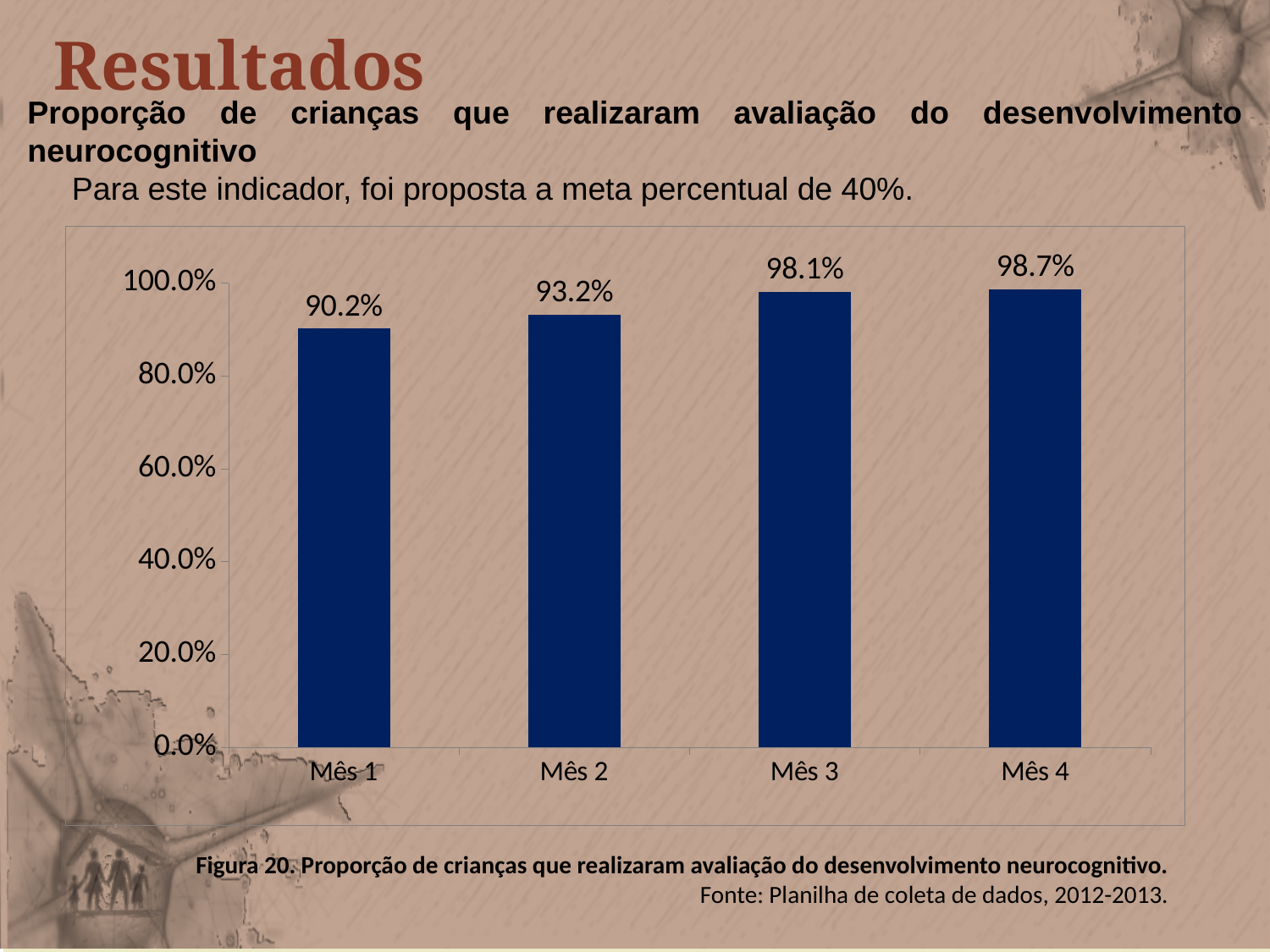
What is the difference between the values for Mês 4 and Mês 1? 8.5% What kind of chart is shown on the slide? bar chart Do the values rise or fall from Mês 1 to Mês 4? rise Is the value for Mês 1 greater or less than 80.0%? greater What is the value for Mês 4? 98.7% How many months are shown on the x axis? 4 Which month has the lowest value? Mês 1 Which month has the highest value? Mês 4 Which is larger, the value for Mês 2 or the value for Mês 3? Mês 3 What is the difference between the values for Mês 2 and Mês 1? 3.0% What is the value for Mês 3? 98.1% What is the value for Mês 1? 90.2%